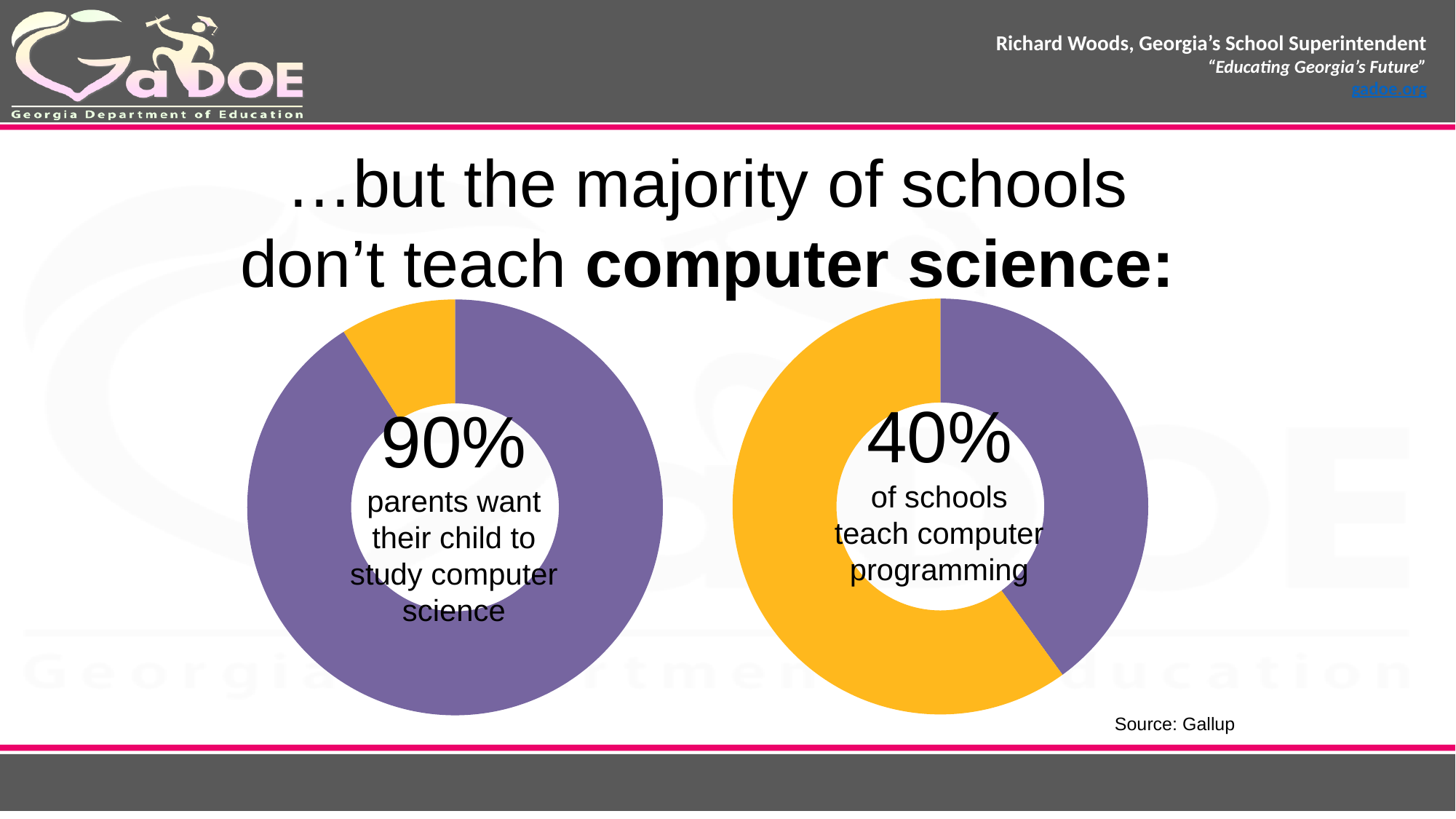
How many slices does each donut chart have? 2 How many charts are shown on the slide? 2 On the left donut chart, what percentage of parents want their child to study computer science? 90% Which is larger: the percentage of parents who want their child to study computer science (left chart) or the percentage of schools that teach computer programming (right chart)? Parents who want their child to study computer science (90%) On the right donut chart, which colour occupies the larger portion of the ring? Yellow What source is cited for the data on the slide? Gallup What kind of charts are shown on the slide? Donut (pie) charts On the left donut chart, is the value for parents who want their child to study computer science greater or less than 50%? greater On the right donut chart, is the value for schools that teach computer programming greater or less than 50%? less On the right donut chart, what percentage of schools teach computer programming? 40% On the left donut chart, which colour represents the 90% share? Purple What is the difference between the percentage shown in the left chart (90%) and the percentage shown in the right chart (40%)? 50 percentage points